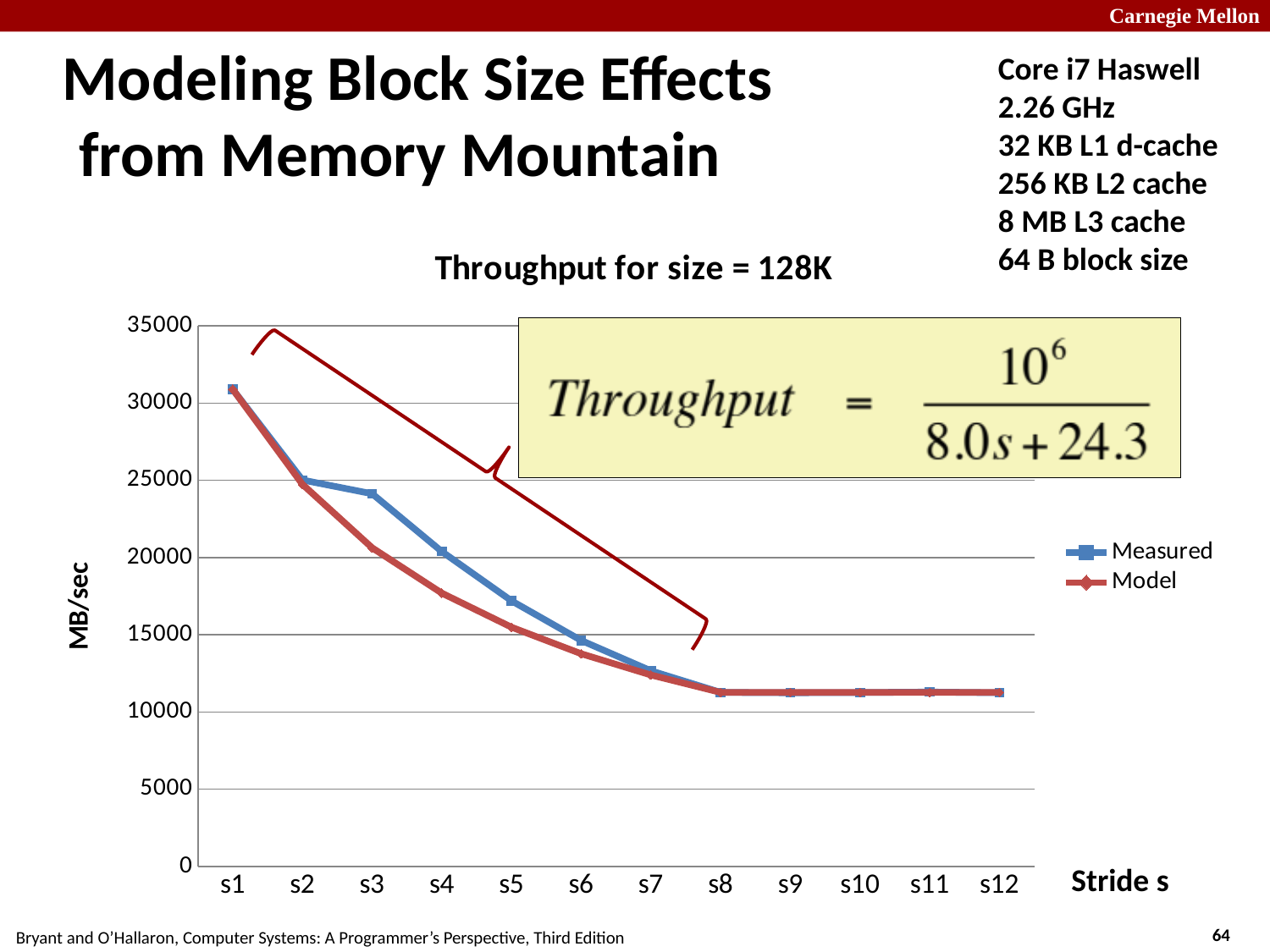
Is the Measured value at s8 greater or less than 15000? less Do the Measured values rise or fall from s1 to s8? fall What kind of chart is shown on the slide? line chart Is the Measured value at s1 greater or less than 25000? greater What is the title of the chart? Throughput for size = 128K Is the Model value at s4 greater or less than 15000? greater At which stride is the Measured throughput highest? s1 How many series does the legend list? 2 At stride s3, which series has the larger value, Measured or Model? Measured What is the label on the y axis? MB/sec At stride s4, which series has the larger value, Measured or Model? Measured How many stride values are plotted along the x axis? 12